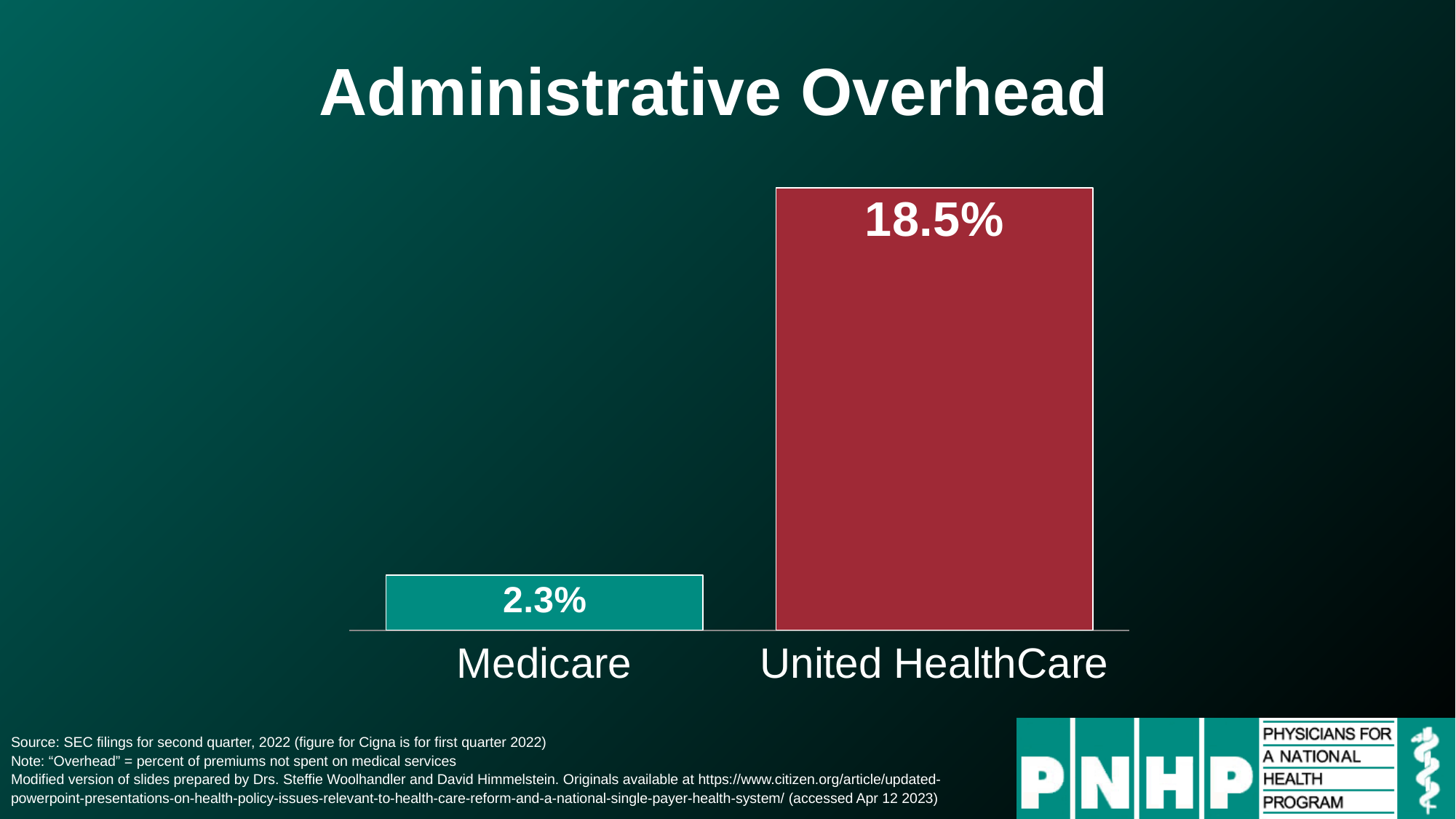
What is the difference in administrative overhead between United HealthCare and Medicare? 16.2% How many categories are shown in the chart? 2 What is the administrative overhead value shown for United HealthCare? 18.5% What is the administrative overhead value shown for Medicare? 2.3% Which category has the lowest administrative overhead? Medicare Which has a larger administrative overhead, Medicare or United HealthCare? United HealthCare What is the title of the chart? Administrative Overhead Which category has the highest administrative overhead? United HealthCare What kind of chart is shown on the slide? Bar chart What colour is the bar for United HealthCare? Red